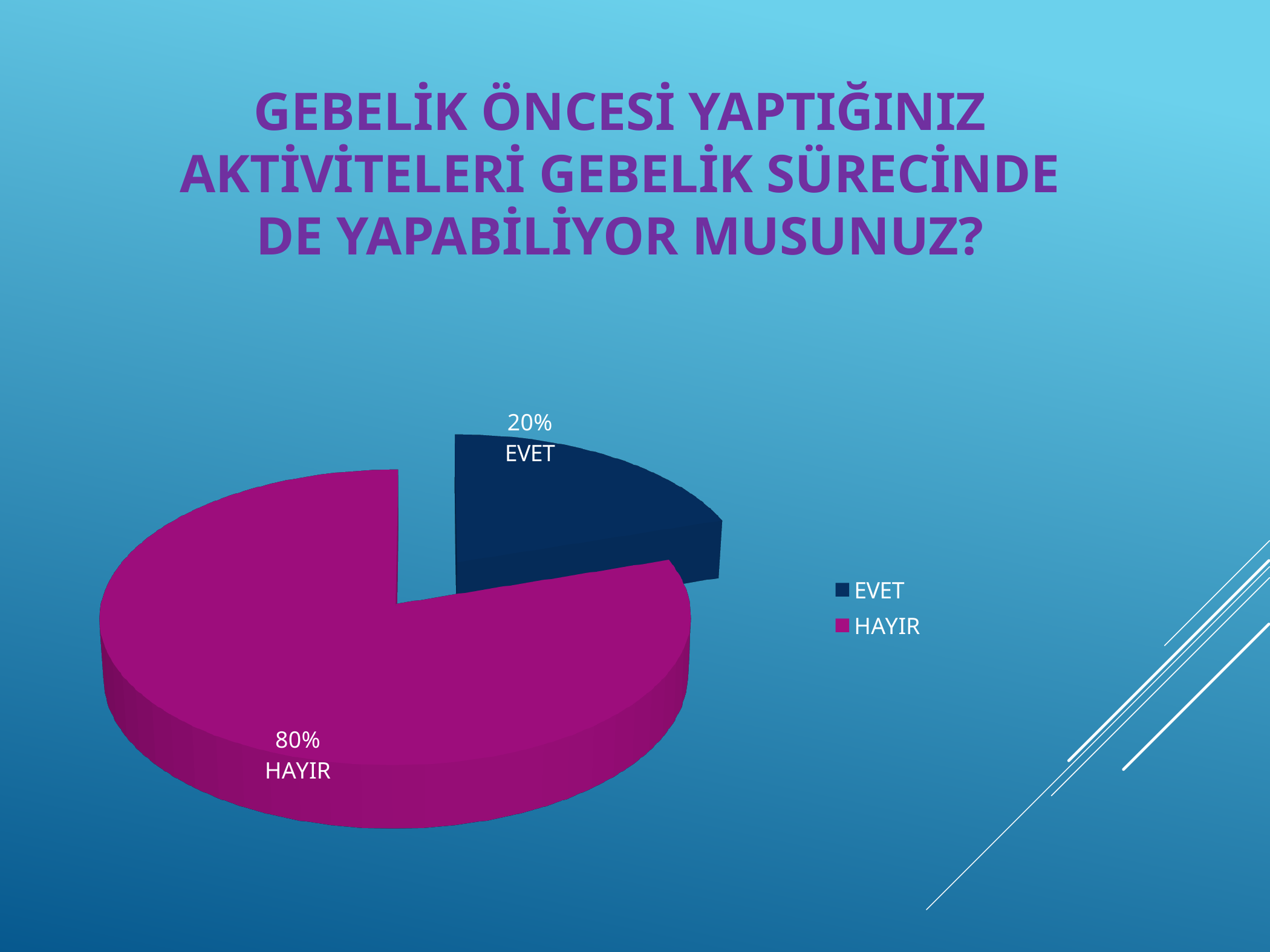
What colour is the HAYIR slice? Magenta Which legend entry is shown in dark blue? EVET Which slice is larger, EVET or HAYIR? HAYIR Which category has the smallest share of the pie? EVET Which category has the largest share of the pie? HAYIR What share of the pie does the EVET slice represent? 20% How many slices does the pie chart have? 2 What percentage of the pie is labelled EVET? 20% How many entries does the legend list? 2 What percentage of the pie is labelled HAYIR? 80% What kind of chart is shown on the slide? Pie chart What is the difference in percentage points between the HAYIR and EVET slices? 60